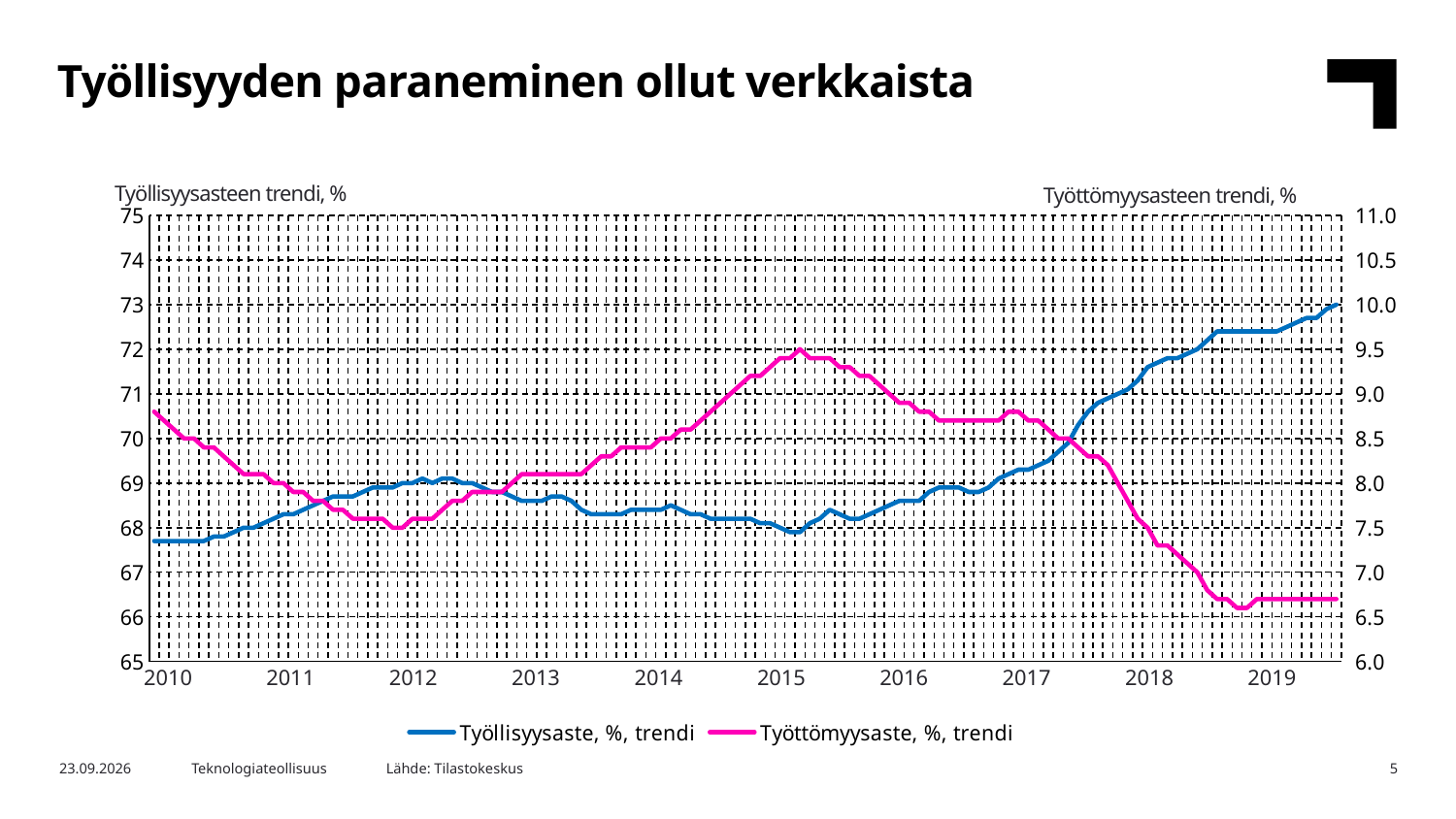
Is the value of Työllisyysaste, %, trendi at the start of 2010 greater or less than 68? less What is the title of the left-hand vertical axis? Työllisyysasteen trendi, % In which year does the Työttömyysaste, %, trendi line reach its highest point? 2015 How many series does the legend list? 2 What kind of chart is shown on the slide? line chart Which series is plotted against the right-hand axis (Työttömyysasteen trendi, %)? Työttömyysaste, %, trendi Does the Työllisyysaste, %, trendi line rise or fall overall from 2010 to 2019? rise Is the value of Työttömyysaste, %, trendi at the start of 2015 greater or less than 9.0? greater How many year labels are shown on the x axis? 10 Is the value of Työttömyysaste, %, trendi at the end of 2019 greater or less than 7.0? less Does the Työttömyysaste, %, trendi line rise or fall from 2015 to 2019? fall